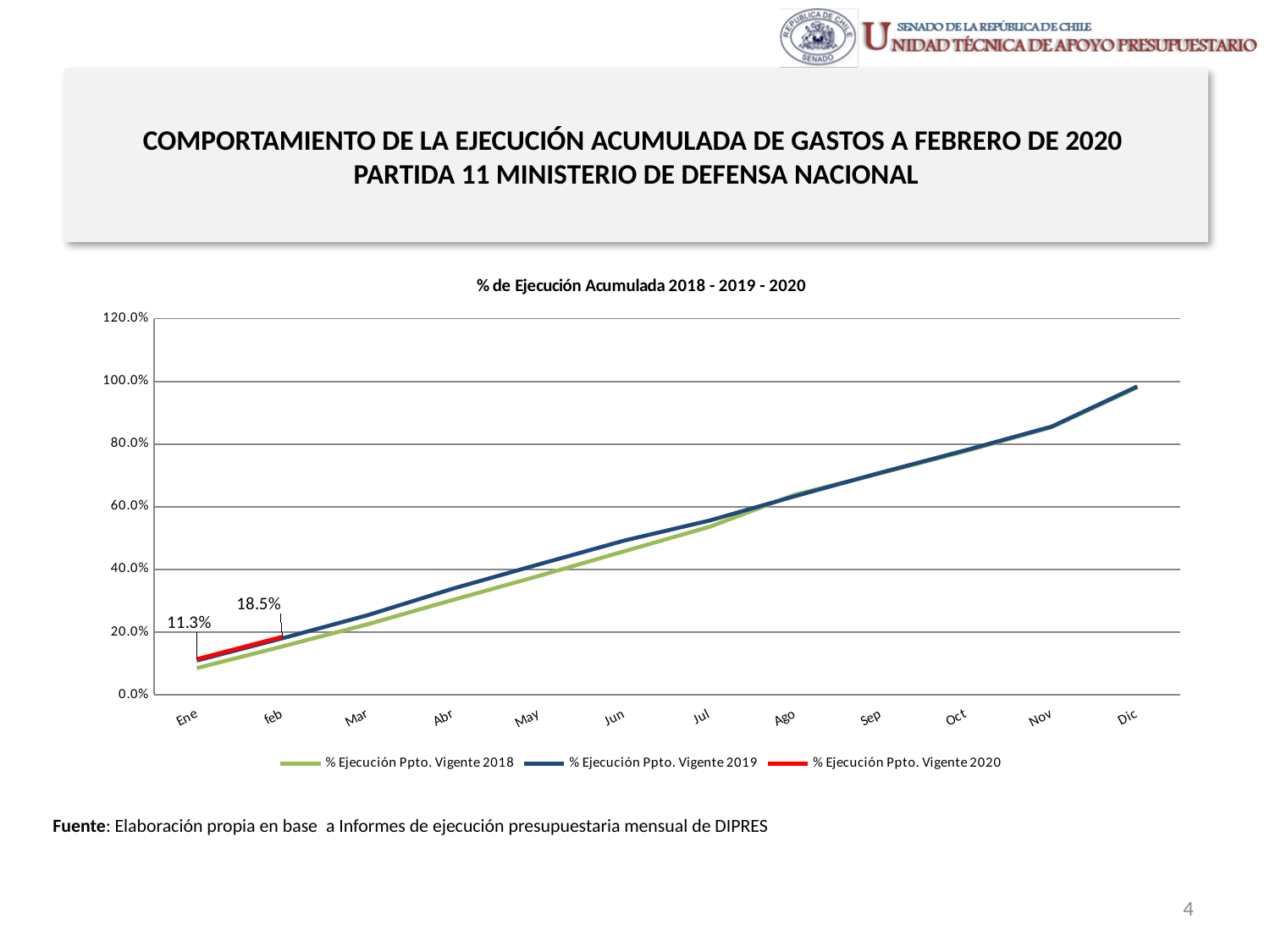
How many series does the legend list? 3 By how much did % Ejecución Ppto. Vigente 2020 increase from Ene to feb? 7.2% In Jun, which series has the higher value: % Ejecución Ppto. Vigente 2018 or % Ejecución Ppto. Vigente 2019? % Ejecución Ppto. Vigente 2019 Is the value for % Ejecución Ppto. Vigente 2019 in Dic greater or less than 80.0%? greater What is the value of % Ejecución Ppto. Vigente 2020 for feb? 18.5% Is the value for % Ejecución Ppto. Vigente 2018 in Ene greater or less than 20.0%? less Does the % Ejecución Ppto. Vigente 2019 series rise or fall from Ene to Dic? Rise What is the title of the chart? % de Ejecución Acumulada 2018 - 2019 - 2020 What colour is the line for % Ejecución Ppto. Vigente 2020? Red How many months are shown on the x axis? 12 What kind of chart is shown on the slide? Line chart What is the value of % Ejecución Ppto. Vigente 2020 for Ene? 11.3%